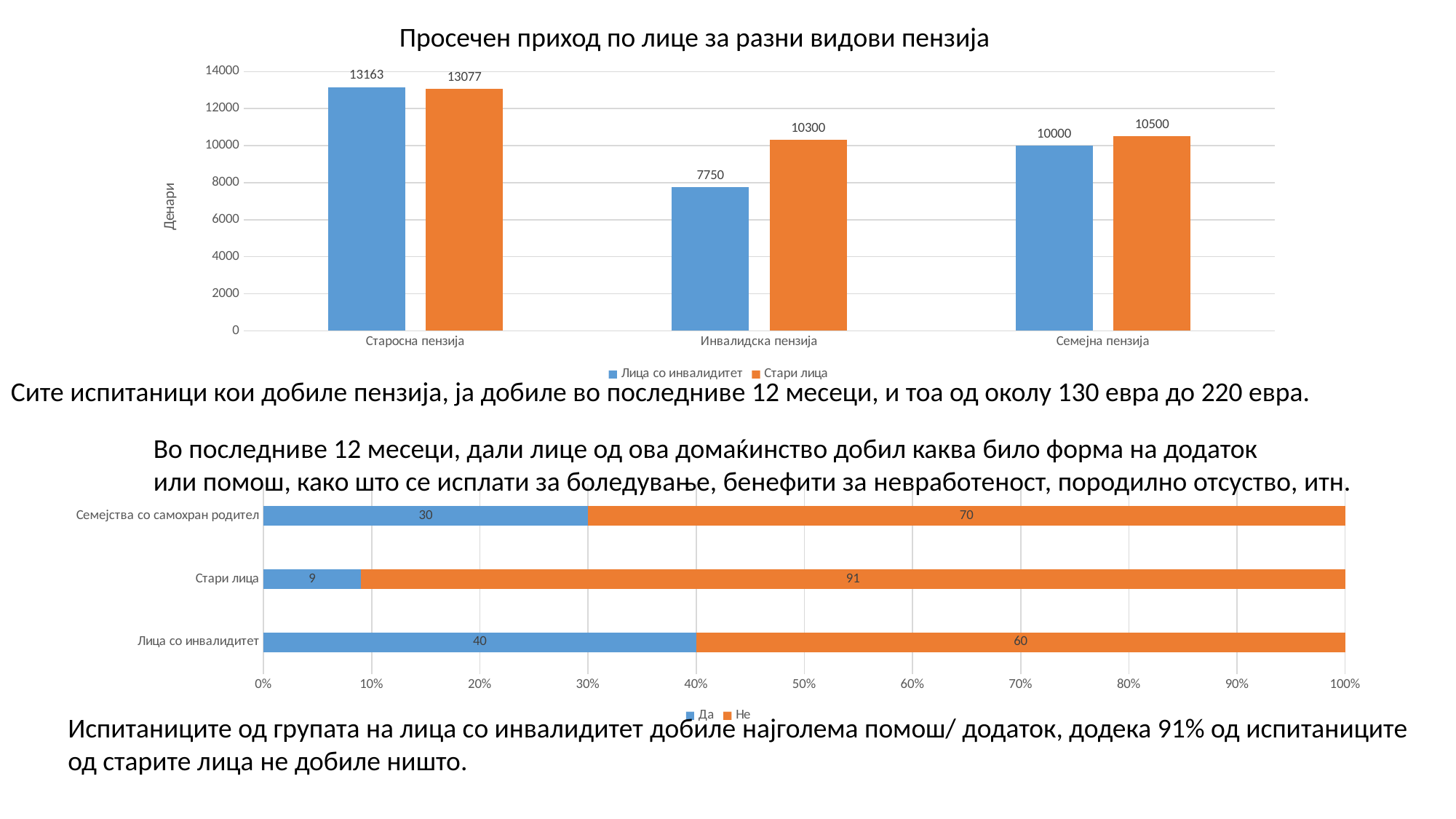
In the top chart 'Просечен приход по лице за разни видови пензија', what is the difference between 'Стари лица' and 'Лица со инвалидитет' in the 'Инвалидска пензија' category? 2550 In the bottom chart, what is the value of 'Да' for 'Стари лица'? 9 In the bottom chart, what is the total of the stacked bar for 'Лица со инвалидитет'? 100 In the top chart 'Просечен приход по лице за разни видови пензија', what is the value for 'Лица со инвалидитет' in the 'Старосна пензија' category? 13163 In the top chart 'Просечен приход по лице за разни видови пензија', how many categories are shown on the x axis? 3 What kind of chart is the bottom chart on the slide? Stacked bar chart In the bottom chart, which category has the highest value for 'Да'? Лица со инвалидитет In the top chart 'Просечен приход по лице за разни видови пензија', what is the value for 'Стари лица' in the 'Инвалидска пензија' category? 10300 In the bottom chart, what is the value of 'Не' for 'Семејства со самохран родител'? 70 In the top chart 'Просечен приход по лице за разни видови пензија', which is larger for 'Семејна пензија': 'Лица со инвалидитет' or 'Стари лица'? Стари лица In the top chart 'Просечен приход по лице за разни видови пензија', which category has the lowest value for 'Лица со инвалидитет'? Инвалидска пензија In the top chart 'Просечен приход по лице за разни видови пензија', how many series does the legend list? 2